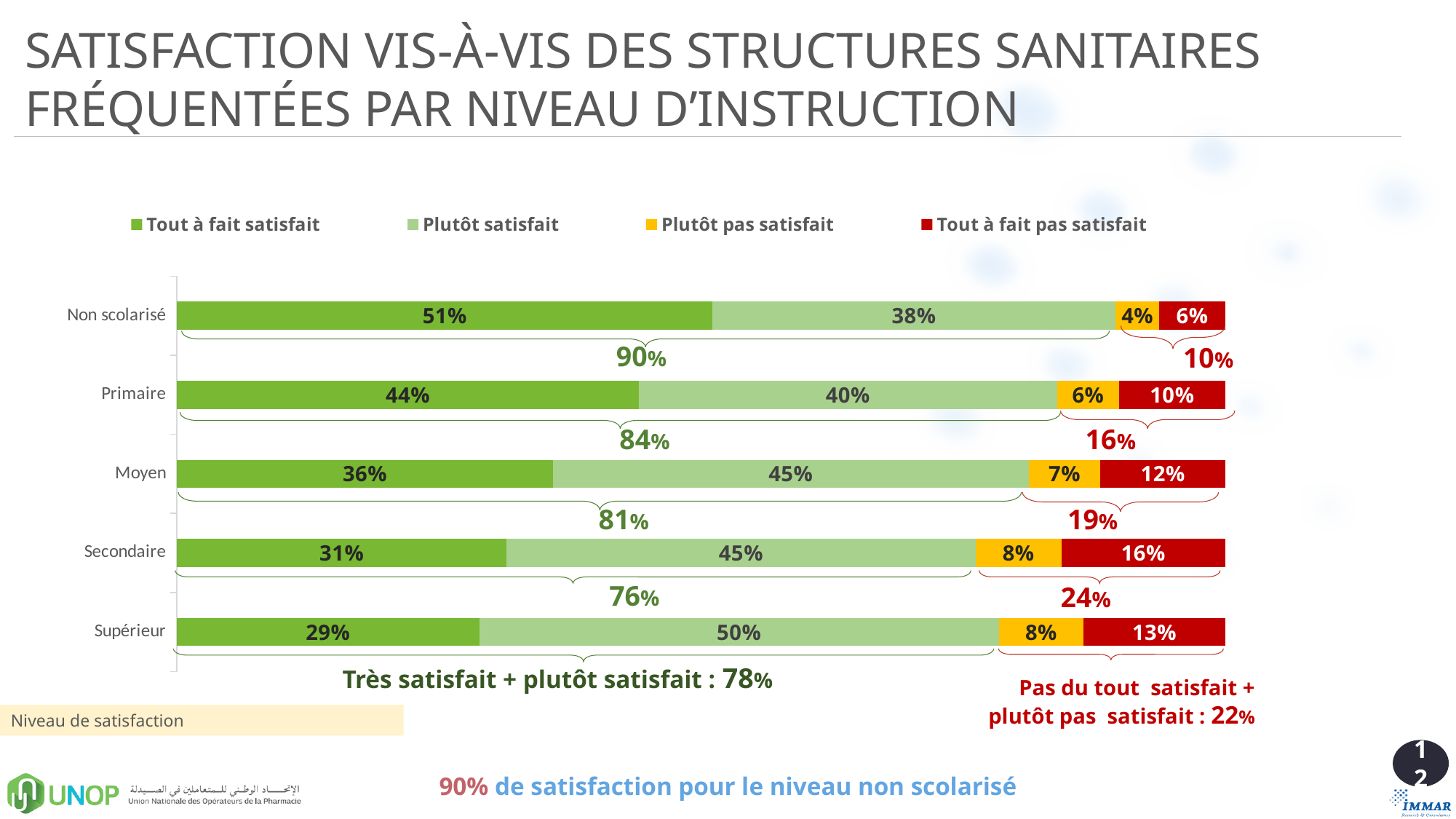
What is the 'Tout à fait pas satisfait' value for Secondaire? 16% What kind of chart is shown on the slide? Stacked bar chart What is the combined 'Tout à fait satisfait' plus 'Plutôt satisfait' share for Secondaire? 76% How many series does the legend list? 4 Which is larger: the 'Tout à fait pas satisfait' value for Moyen or for Supérieur? Supérieur What is the 'Plutôt pas satisfait' value for Moyen? 7% What is the 'Tout à fait satisfait' value for Non scolarisé? 51% What is the 'Plutôt satisfait' value for Supérieur? 50% Which education level has the lowest 'Tout à fait satisfait' value? Supérieur Which education level has the highest 'Tout à fait satisfait' value? Non scolarisé How many education levels are shown on the chart? 5 What is the difference between the 'Tout à fait satisfait' values for Non scolarisé and Primaire? 7%